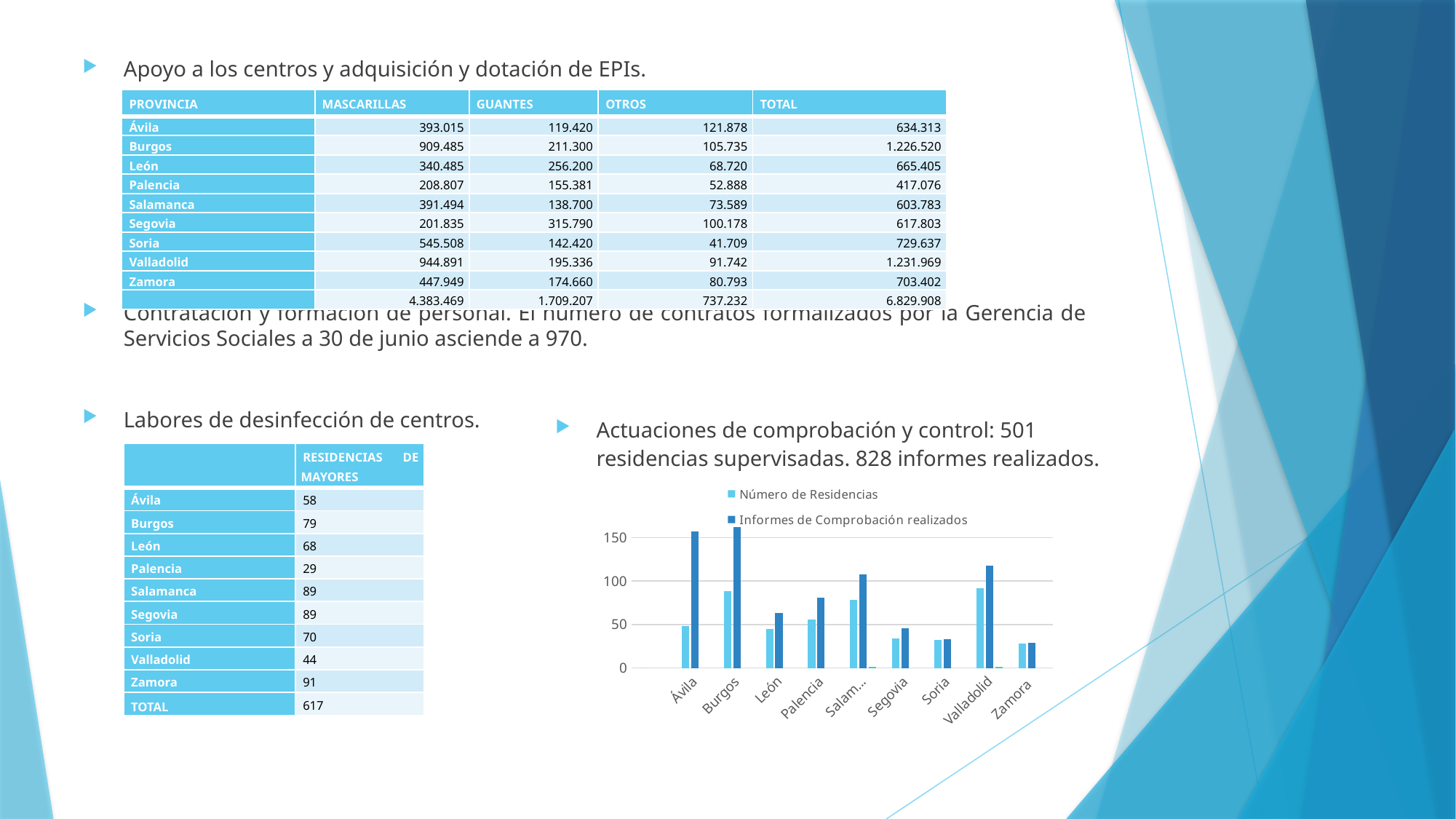
Which has a larger Informes de Comprobación realizados value: Valladolid or Zamora? Valladolid For Ávila, which is larger: Número de Residencias or Informes de Comprobación realizados? Informes de Comprobación realizados What are the two series named in the chart's legend? Número de Residencias; Informes de Comprobación realizados Is the value of Número de Residencias for Burgos greater or less than 100? less How many provinces are shown on the x axis of the chart? 9 Is the value of Número de Residencias for Segovia greater or less than 50? less Is the value of Informes de Comprobación realizados for Ávila greater or less than 150? greater How many series does the chart's legend list? 2 Which has a larger Número de Residencias value: Burgos or Segovia? Burgos What kind of chart is shown on the slide? bar chart